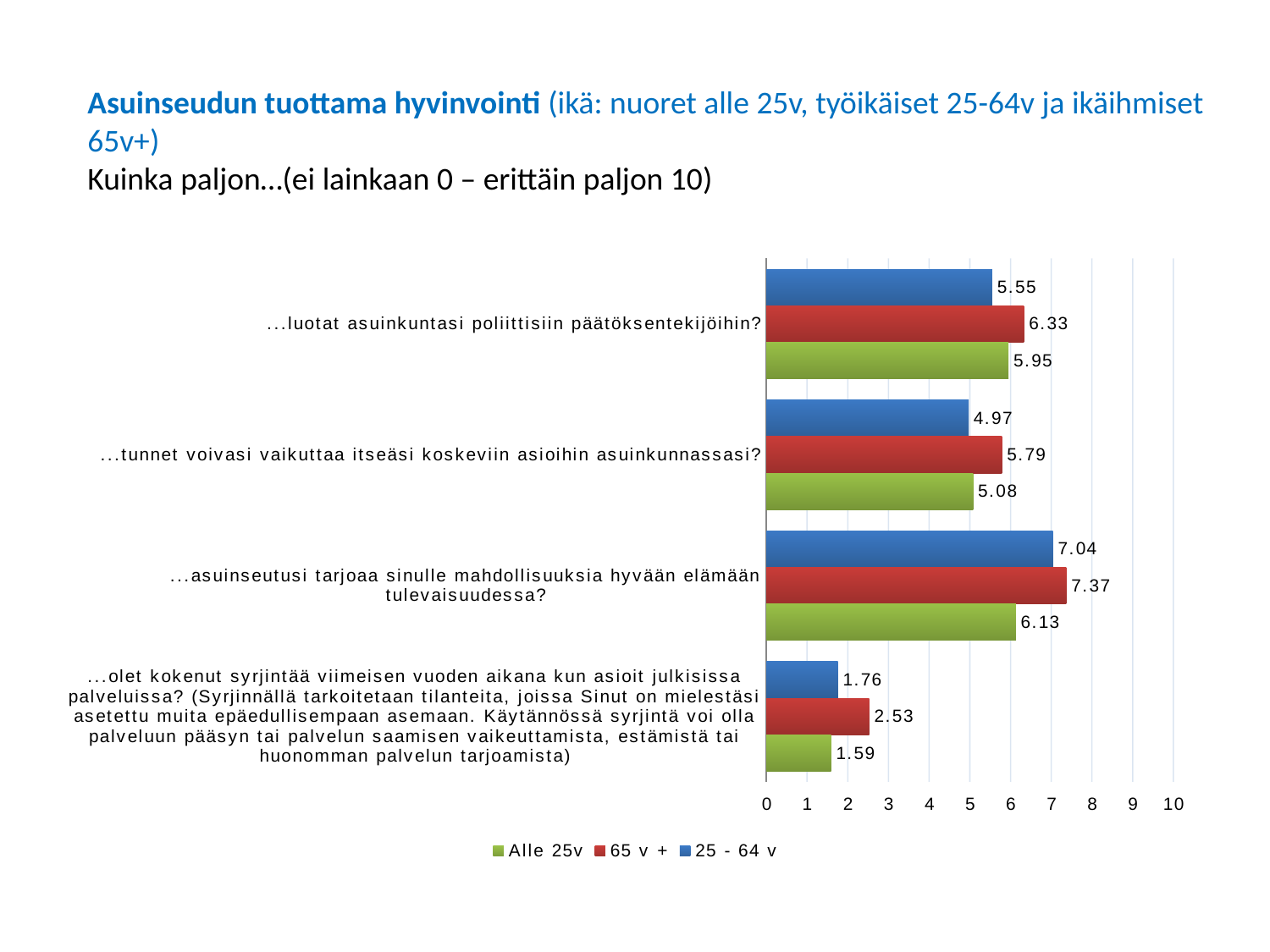
What is the value for the 65 v + series for the question about experiencing discrimination ("...olet kokenut syrjintää...")? 2.53 Which is larger for "...luotat asuinkuntasi poliittisiin päätöksentekijöihin?": the Alle 25v value or the 25 - 64 v value? Alle 25v Which colour represents the 65 v + series in the chart? red What is the difference between the 65 v + and 25 - 64 v values for "...tunnet voivasi vaikuttaa itseäsi koskeviin asioihin asuinkunnassasi?"? 0.82 Which series has the lowest value for the question about experiencing discrimination ("...olet kokenut syrjintää...")? Alle 25v How many series does the legend list? 3 What is the value for the Alle 25v series for "...asuinseutusi tarjoaa sinulle mahdollisuuksia hyvään elämään tulevaisuudessa?"? 6.13 Which series has the highest value for "...asuinseutusi tarjoaa sinulle mahdollisuuksia hyvään elämään tulevaisuudessa?"? 65 v + How many question categories are plotted on the chart? 4 What kind of chart is shown on the slide? bar chart What is the value for the 65 v + series for "...luotat asuinkuntasi poliittisiin päätöksentekijöihin?"? 6.33 What is the value for the 25 - 64 v series for "...tunnet voivasi vaikuttaa itseäsi koskeviin asioihin asuinkunnassasi?"? 4.97